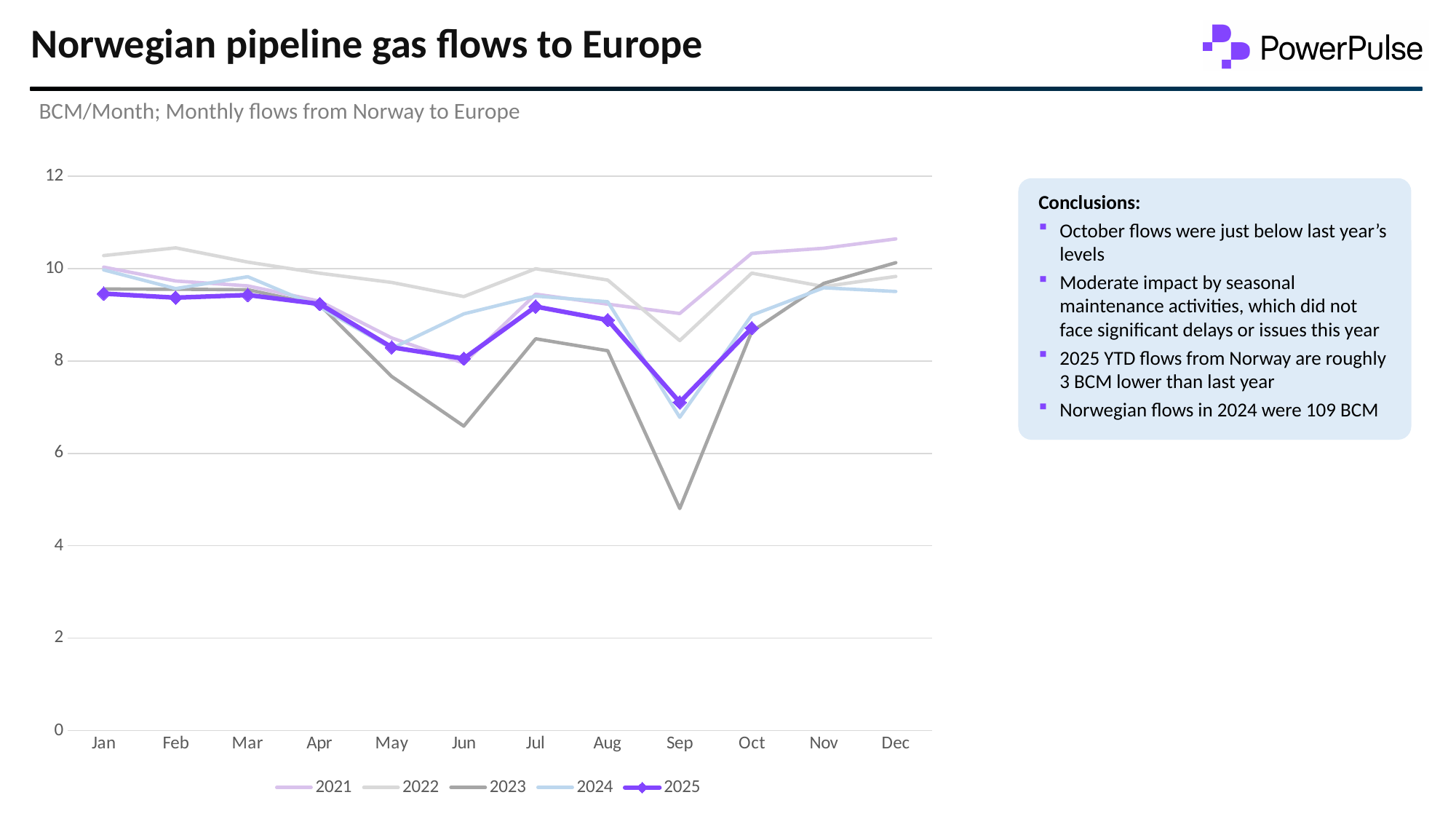
In which month is the 2023 value lowest? Sep Is the 2025 value for Sep greater or less than 8? less What kind of chart is shown on the slide? line chart Which series has the lowest value in Sep? 2023 In which month is the 2025 value lowest? Sep Which series is drawn with diamond markers? 2025 How many series does the legend list? 5 Is the 2022 value for Feb greater or less than 10? greater Is the 2023 value for Jun greater or less than 8? less How many months are shown on the x axis? 12 Does the 2025 line rise or fall from Apr to Jun? fall